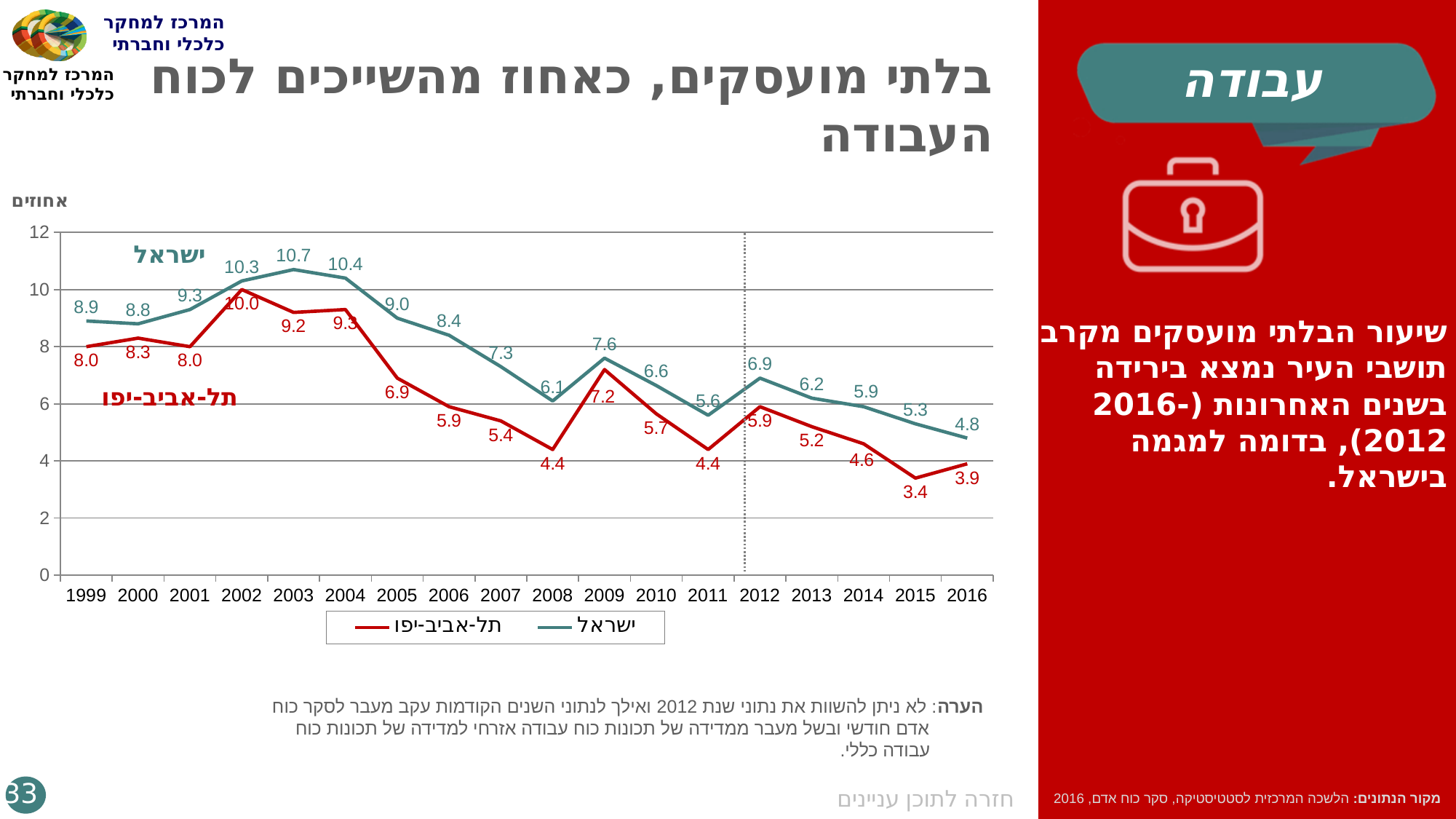
Which series has the higher value in 2008, ישראל or תל-אביב-יפו? ישראל In which year does the ישראל series reach its highest value? 2003 Does the ישראל series rise or fall from 2012 to 2016? fall What is the value for תל-אביב-יפו in 2009? 7.2 What is the value for ישראל in 2003? 10.7 How many series does the legend list? 2 What is the value for תל-אביב-יפו in 2016? 3.9 Is the value for תל-אביב-יפו in 2002 greater or less than 8? greater How many years are shown on the x axis? 18 What is the difference between the ישראל and תל-אביב-יפו values in 2016? 0.9 What kind of chart is shown on the slide? line chart In which year does the תל-אביב-יפו series reach its lowest value? 2015